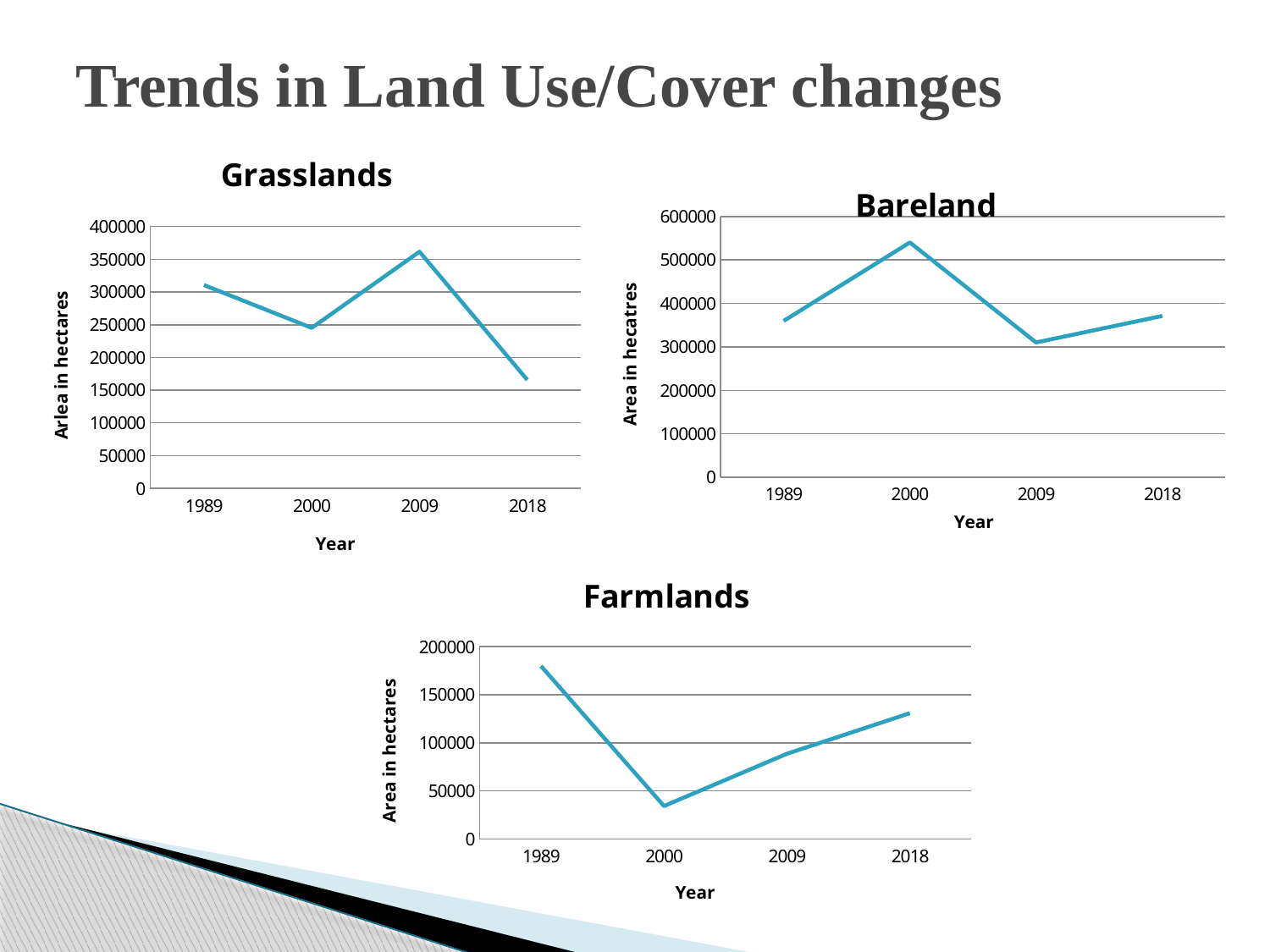
In the Bareland chart, is the value for 2000 greater or less than 500000? greater In the Bareland chart, which year has the lowest area? 2009 In the Grasslands chart, which year has the highest area? 2009 How many years are plotted on the x axis of the Grasslands chart? 4 In the Grasslands chart, is the value for 2018 greater or less than 200000? less In the Bareland chart, which year has the highest area? 2000 In the Farmlands chart, is the value for 2000 greater or less than 50000? less In the Farmlands chart, is the value for 2018 larger or smaller than the value for 2009? larger In the Farmlands chart, which year has the highest area? 1989 What kind of chart is the Bareland chart? line chart In the Grasslands chart, which year has the lowest area? 2018 In the Farmlands chart, which year has the lowest area? 2000